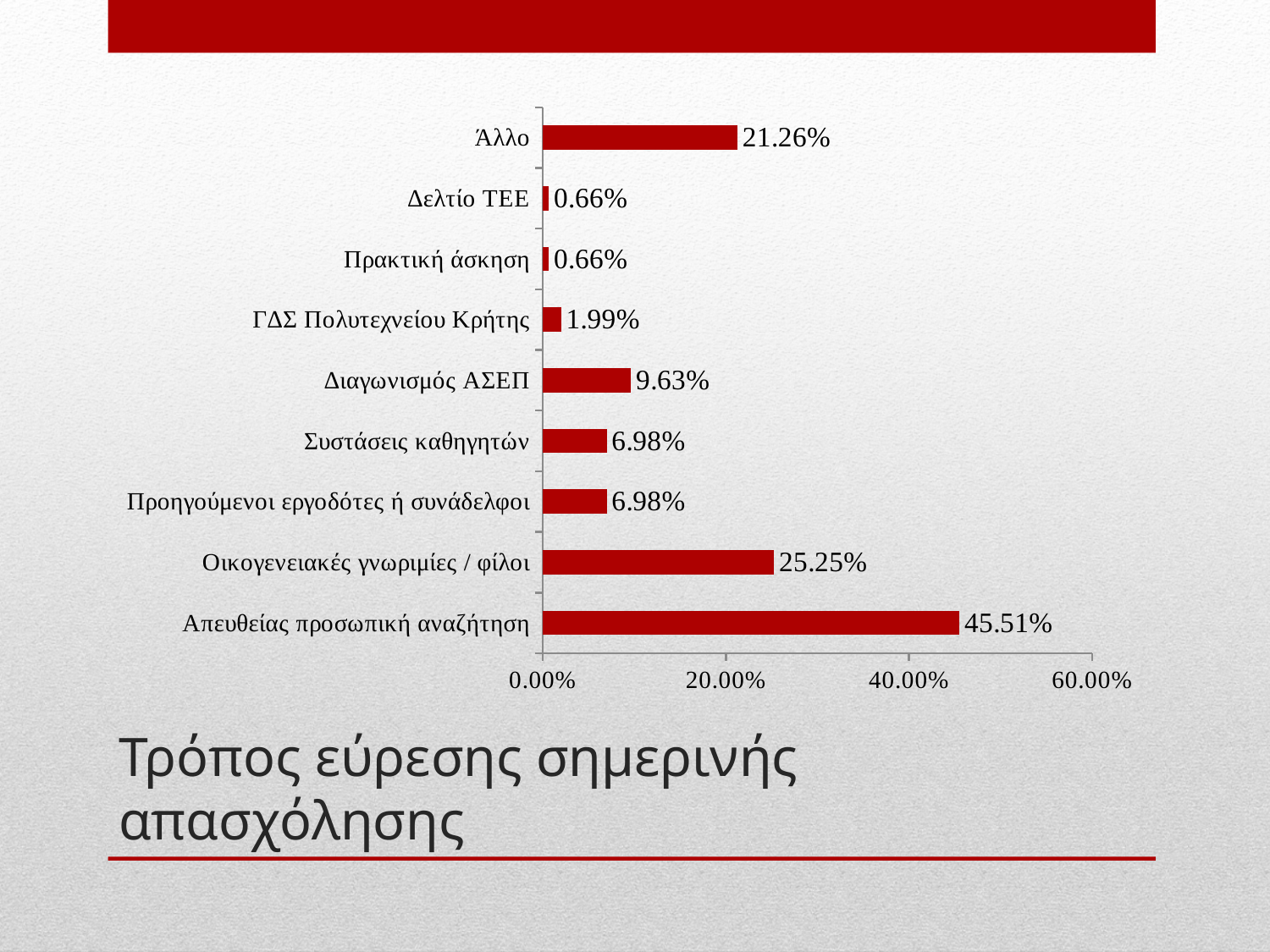
What is the value for Διαγωνισμός ΑΣΕΠ? 9.63% What is the value for Οικογενειακές γνωριμίες / φίλοι? 25.25% What is the title of the slide? Τρόπος εύρεσης σημερινής απασχόλησης How many categories are shown in the chart? 9 What is the value for Άλλο? 21.26% Which category has the highest value? Απευθείας προσωπική αναζήτηση Is the value for Οικογενειακές γνωριμίες / φίλοι greater or less than 20.00%? greater Which is larger, Άλλο or Διαγωνισμός ΑΣΕΠ? Άλλο What kind of chart is shown on the slide? bar chart What is the value for Απευθείας προσωπική αναζήτηση? 45.51% What is the difference between Απευθείας προσωπική αναζήτηση and Οικογενειακές γνωριμίες / φίλοι? 20.26% What is the value for ΓΔΣ Πολυτεχνείου Κρήτης? 1.99%